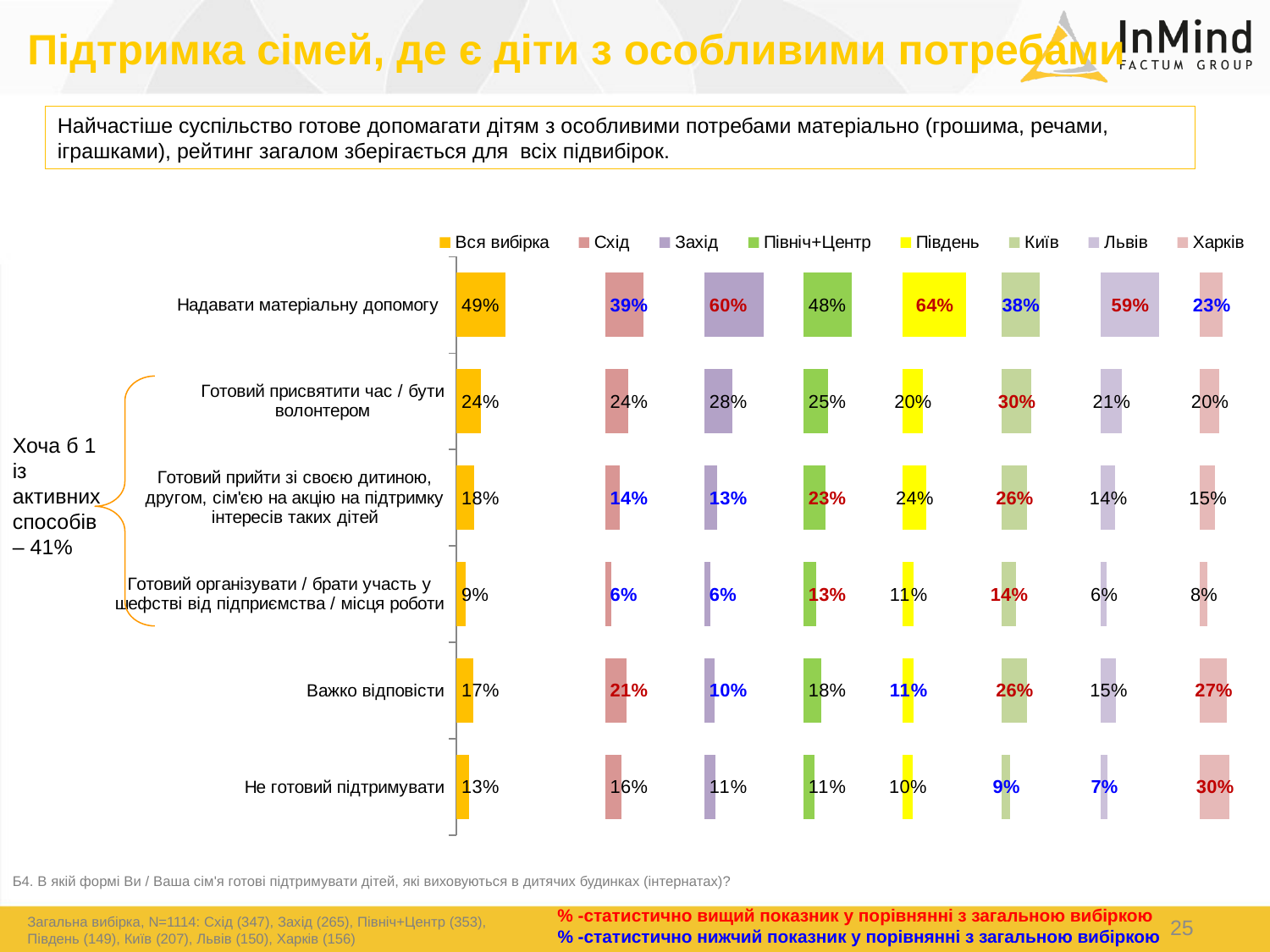
Which series has the lowest value in the category Надавати матеріальну допомогу? Харків What kind of chart is shown on the slide? Bar chart What is the value for Вся вибірка in the category Надавати матеріальну допомогу? 49% Which series has the highest value in the category Надавати матеріальну допомогу? Південь How many series does the legend list? 8 What colour represents the series Південь in the legend? Yellow What is the difference between the Захід and Схід values in the category Надавати матеріальну допомогу? 21 percentage points What is the value for Харків in the category Не готовий підтримувати? 30% How many categories are shown on the chart? 6 What is the value for Київ in the category Готовий присвятити час / бути волонтером? 30% In the category Важко відповісти, which is larger: the value for Київ or for Львів? Київ What is the difference between the Харків and Львів values in the category Не готовий підтримувати? 23 percentage points